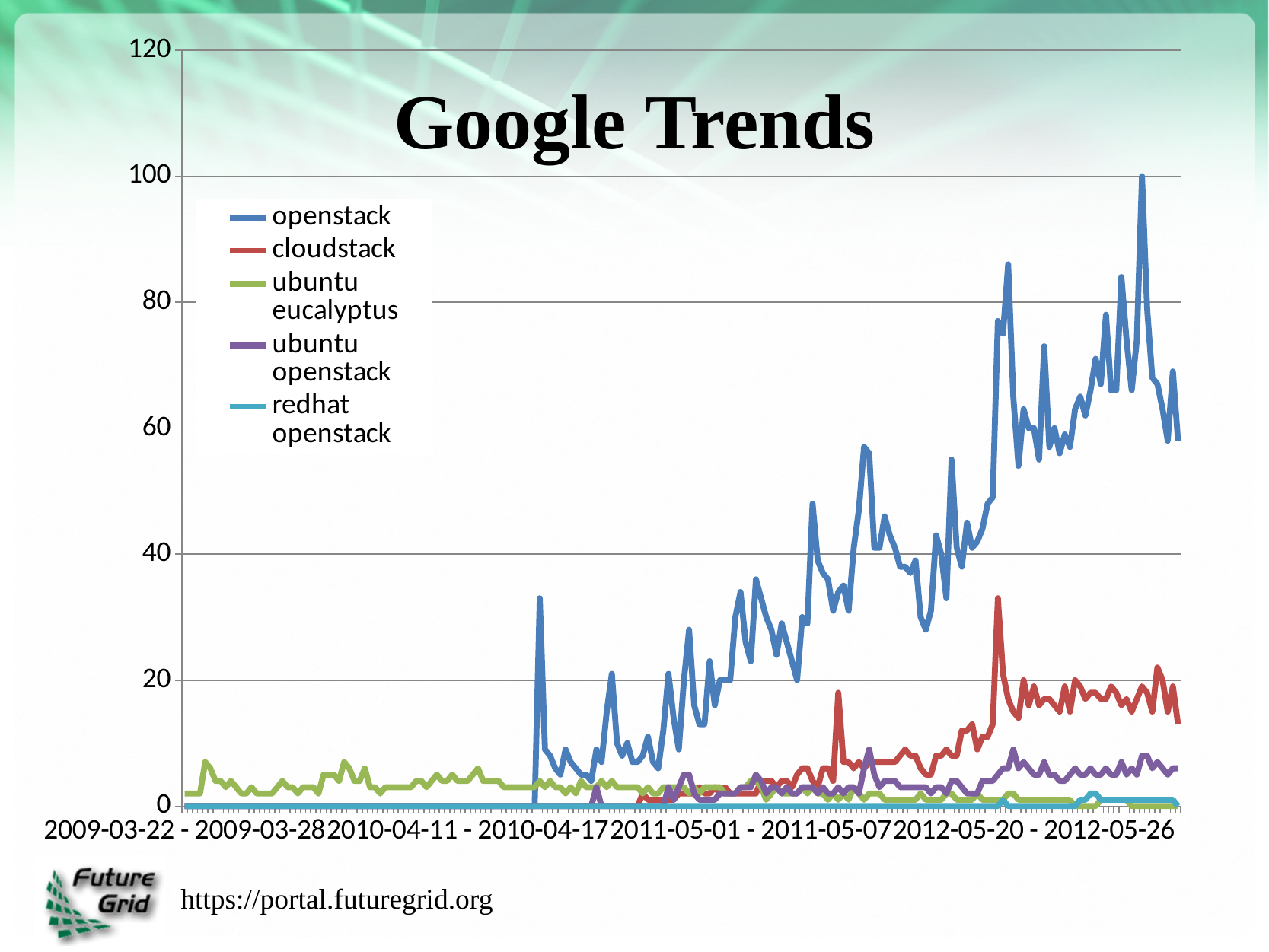
What kind of chart is shown on the slide? line chart At the right end of the chart, which series is larger: openstack or cloudstack? openstack Does the ubuntu eucalyptus series ever rise above 20? No How many series does the legend list? 5 What is the title of the chart? Google Trends Is the peak value of the openstack series greater or less than 80? greater Does the openstack series generally rise or fall from left to right along the x axis? rise Which series reaches the highest value on the chart? openstack What is the peak value reached by the openstack series? 100 Is the peak value of the cloudstack series greater or less than 40? less What colour is the line for the openstack series? blue